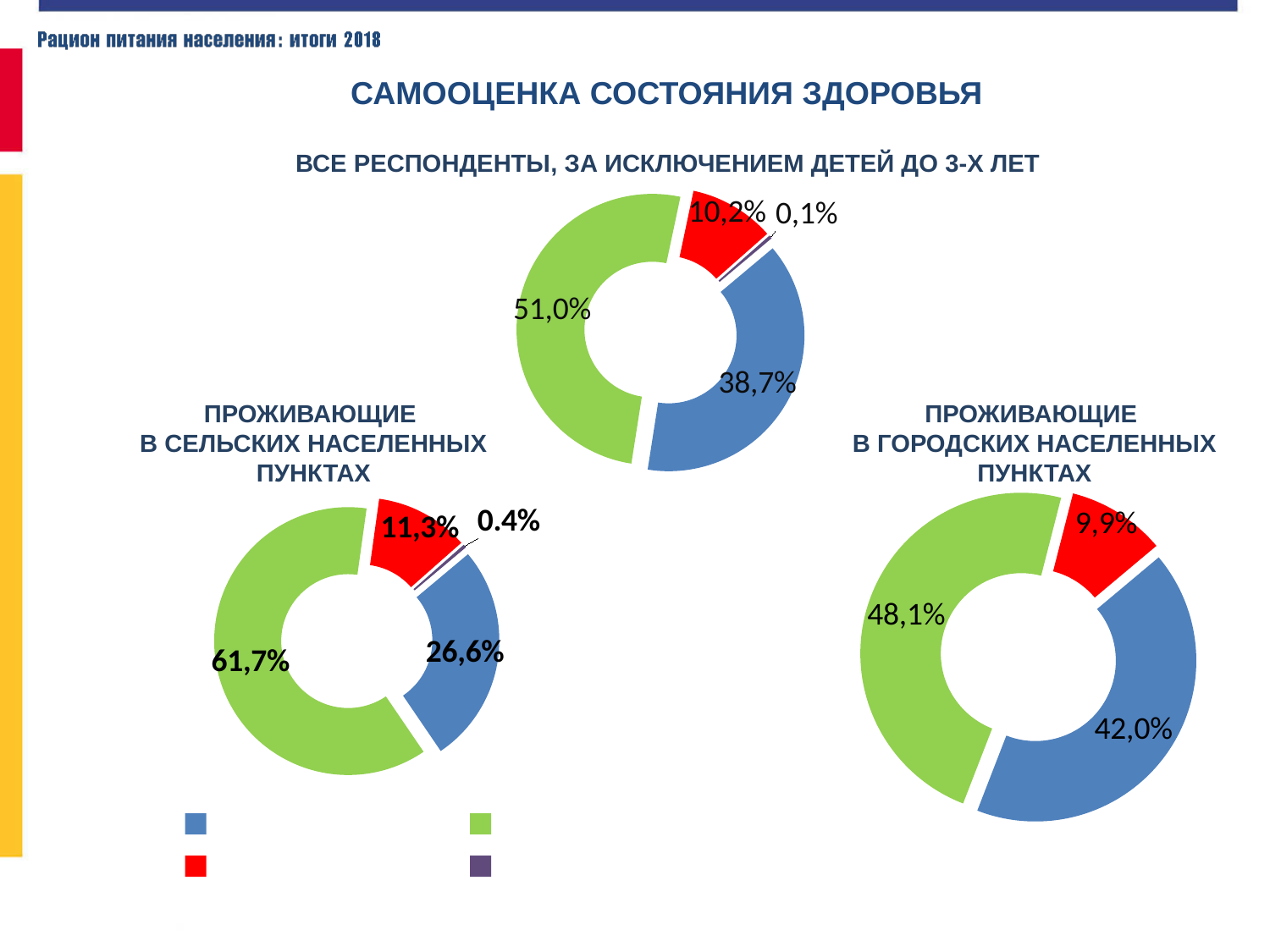
In the chart titled "ВСЕ РЕСПОНДЕНТЫ, ЗА ИСКЛЮЧЕНИЕМ ДЕТЕЙ ДО 3-Х ЛЕТ", what value is shown for the blue segment? 38,7% Which chart shows a larger value for the blue segment: the one for rural residents ("В СЕЛЬСКИХ НАСЕЛЕННЫХ ПУНКТАХ") or the one for urban residents ("В ГОРОДСКИХ НАСЕЛЕННЫХ ПУНКТАХ")? urban (42,0%) In the chart titled "ПРОЖИВАЮЩИЕ В ГОРОДСКИХ НАСЕЛЕННЫХ ПУНКТАХ", what value is shown for the blue segment? 42,0% In the chart titled "ПРОЖИВАЮЩИЕ В СЕЛЬСКИХ НАСЕЛЕННЫХ ПУНКТАХ", which colour segment has the largest value? green In the chart titled "ПРОЖИВАЮЩИЕ В ГОРОДСКИХ НАСЕЛЕННЫХ ПУНКТАХ", what value is shown for the red segment? 9,9% How many colour entries does the legend at the bottom of the slide show? 4 What type of chart is used on this slide? donut (pie) chart In the chart titled "ВСЕ РЕСПОНДЕНТЫ, ЗА ИСКЛЮЧЕНИЕМ ДЕТЕЙ ДО 3-Х ЛЕТ", what value is shown for the green segment? 51,0% In the chart titled "ПРОЖИВАЮЩИЕ В ГОРОДСКИХ НАСЕЛЕННЫХ ПУНКТАХ", which is larger: the green segment or the blue segment? green In the chart titled "ПРОЖИВАЮЩИЕ В СЕЛЬСКИХ НАСЕЛЕННЫХ ПУНКТАХ", what value is shown for the red segment? 11,3% In the chart titled "ВСЕ РЕСПОНДЕНТЫ, ЗА ИСКЛЮЧЕНИЕМ ДЕТЕЙ ДО 3-Х ЛЕТ", what is the smallest value shown? 0,1% In the chart titled "ПРОЖИВАЮЩИЕ В СЕЛЬСКИХ НАСЕЛЕННЫХ ПУНКТАХ", what is the difference between the green segment (61,7%) and the blue segment (26,6%)? 35,1%